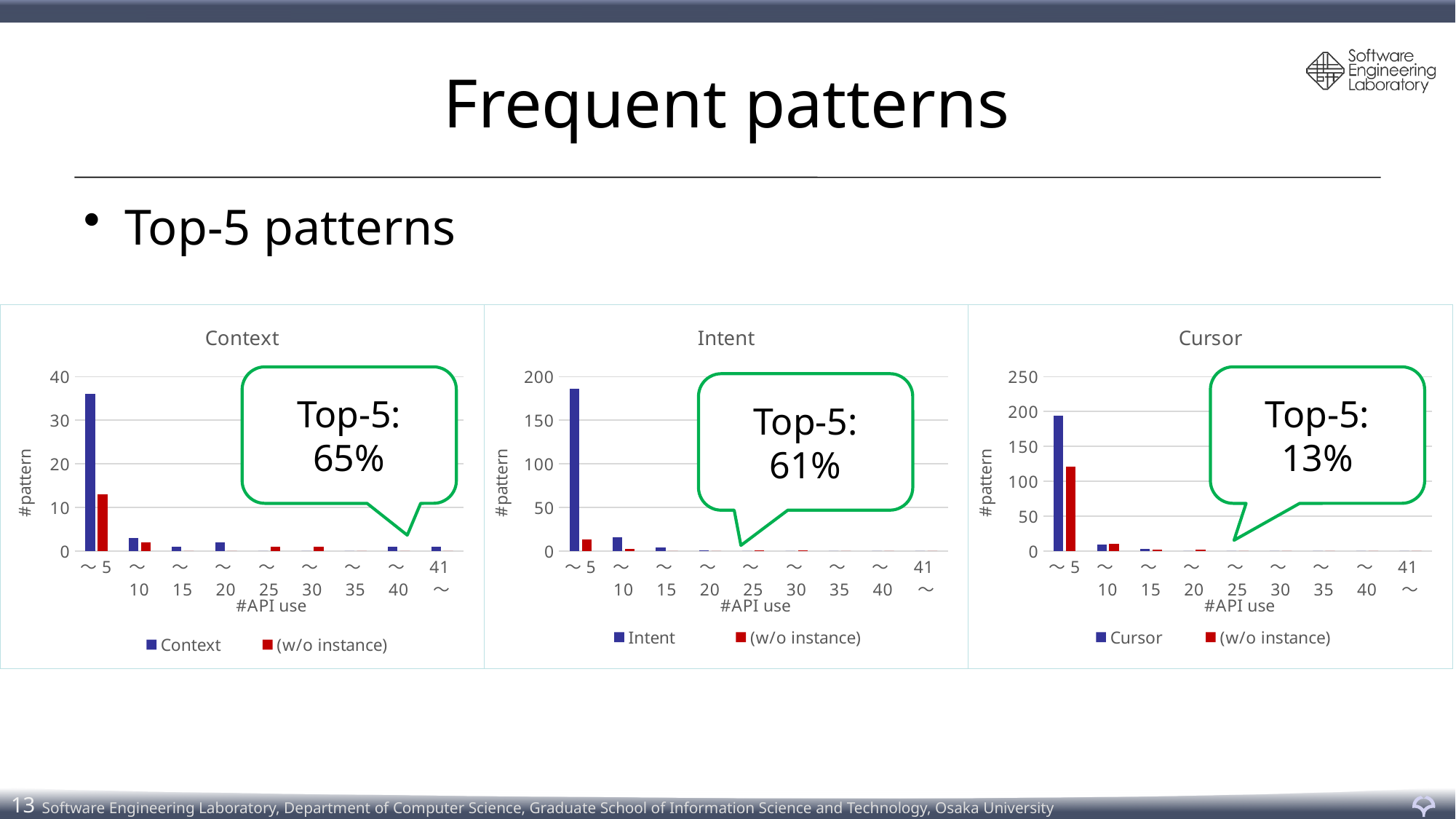
How many #API use categories are shown on the x axis of the Cursor chart? 9 In the Intent chart, is the Intent value for ~5 greater or less than 150? greater How many series does the legend of the Intent chart list? 2 In the Context chart, is the Context value for ~5 greater or less than 30? greater What Top-5 percentage is shown in the callout on the Cursor chart? 13% In the Cursor chart, for the ~5 category, which is larger: Cursor or (w/o instance)? Cursor What kind of chart is the Context chart? bar chart In the Intent chart, which #API use category has the highest Intent value? ~5 In the Cursor chart, which #API use category has the highest Cursor value? ~5 In the Context chart, do the Context values generally rise or fall as #API use increases from ~5 to ~15? fall In the Context chart, which #API use category has the highest Context value? ~5 In the Cursor chart, is the (w/o instance) value for ~5 greater or less than 100? greater